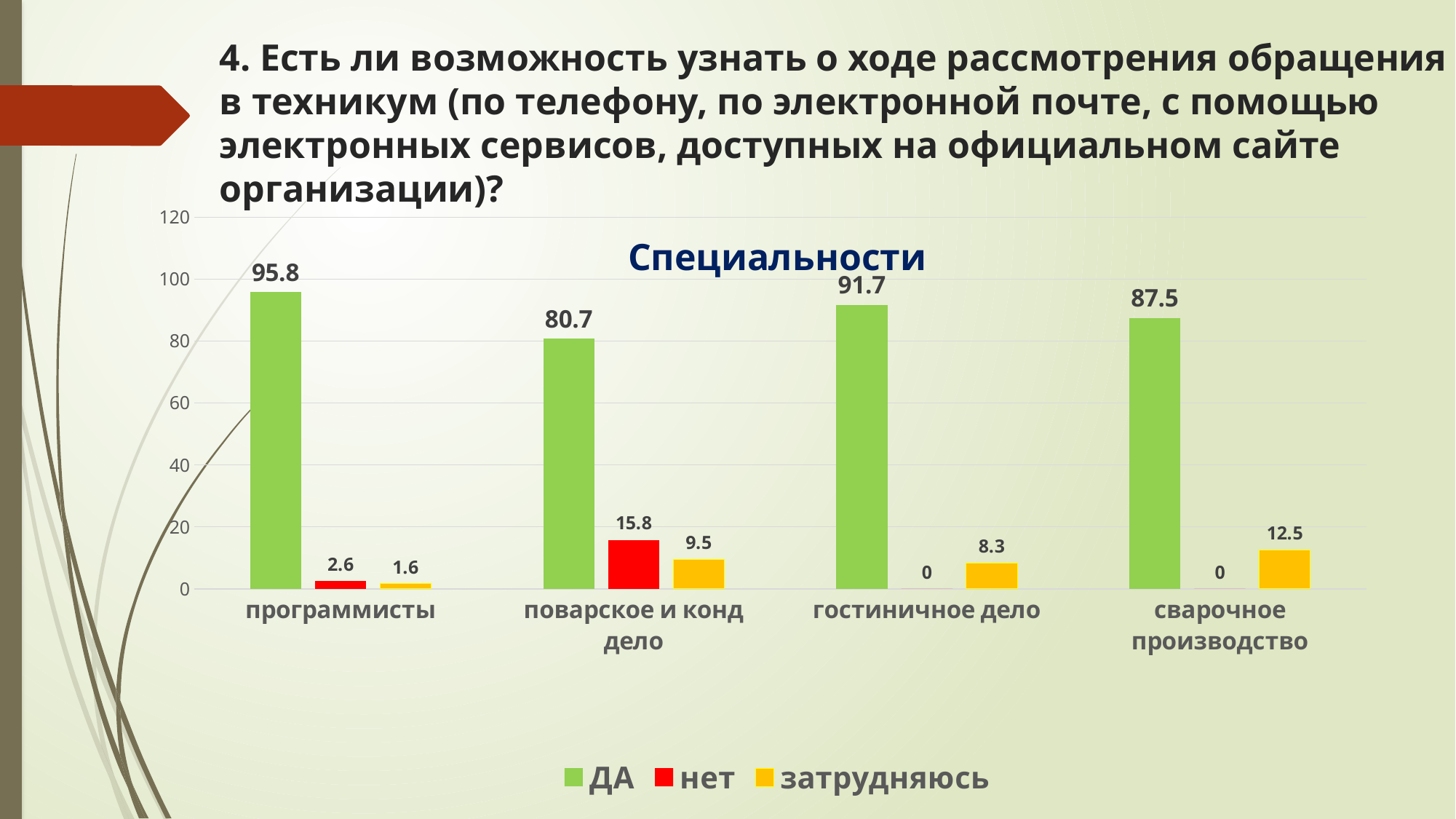
What is the value of the ДА series for программисты? 95.8 How many series does the legend list? 3 What is the value of the нет series for поварское и конд дело? 15.8 Which category has the highest value for the ДА series? программисты What is the value of the затрудняюсь series for сварочное производство? 12.5 How many categories are shown on the x axis? 4 What is the difference between the ДА values for программисты and поварское и конд дело? 15.1 What kind of chart is shown on the slide? bar chart What is the title of the chart? Специальности Which category has the lowest value for the ДА series? поварское и конд дело What is the value of the нет series for гостиничное дело? 0 Which is larger: the затрудняюсь value for гостиничное дело or for сварочное производство? сварочное производство